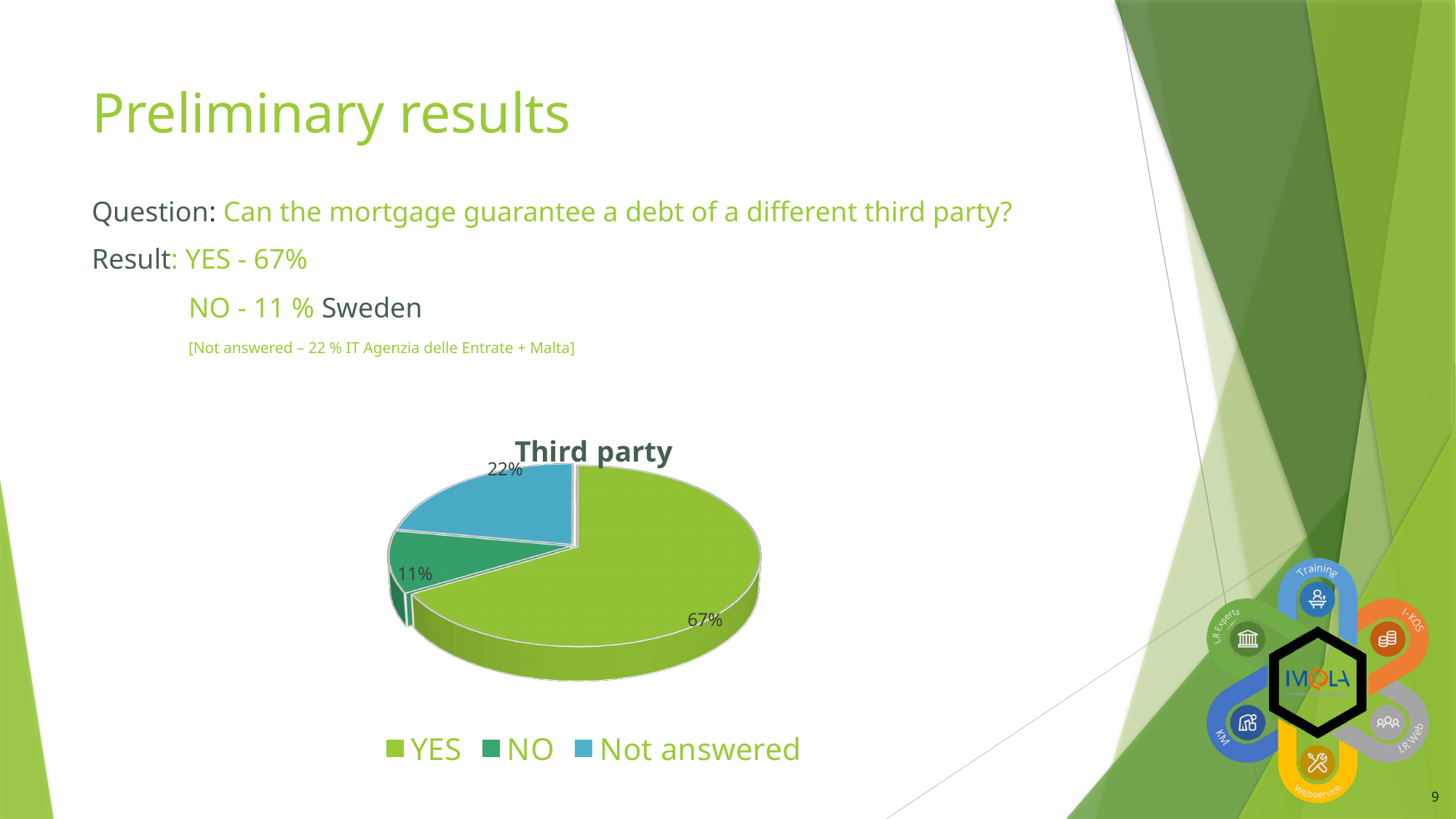
Which slice is larger, NO or Not answered? Not answered What percentage of the pie chart is labelled Not answered? 22% What is the title of the pie chart? Third party What type of chart is shown on the slide? pie chart What percentage of the pie chart is labelled YES? 67% Which category has the largest slice in the pie chart? YES How many entries does the legend of the pie chart list? 3 How many slices does the pie chart have? 3 What is the difference in percentage points between the Not answered slice and the NO slice? 11 What percentage of the pie chart is labelled NO? 11% Which category has the smallest slice in the pie chart? NO What is the difference in percentage points between the YES slice and the Not answered slice? 45